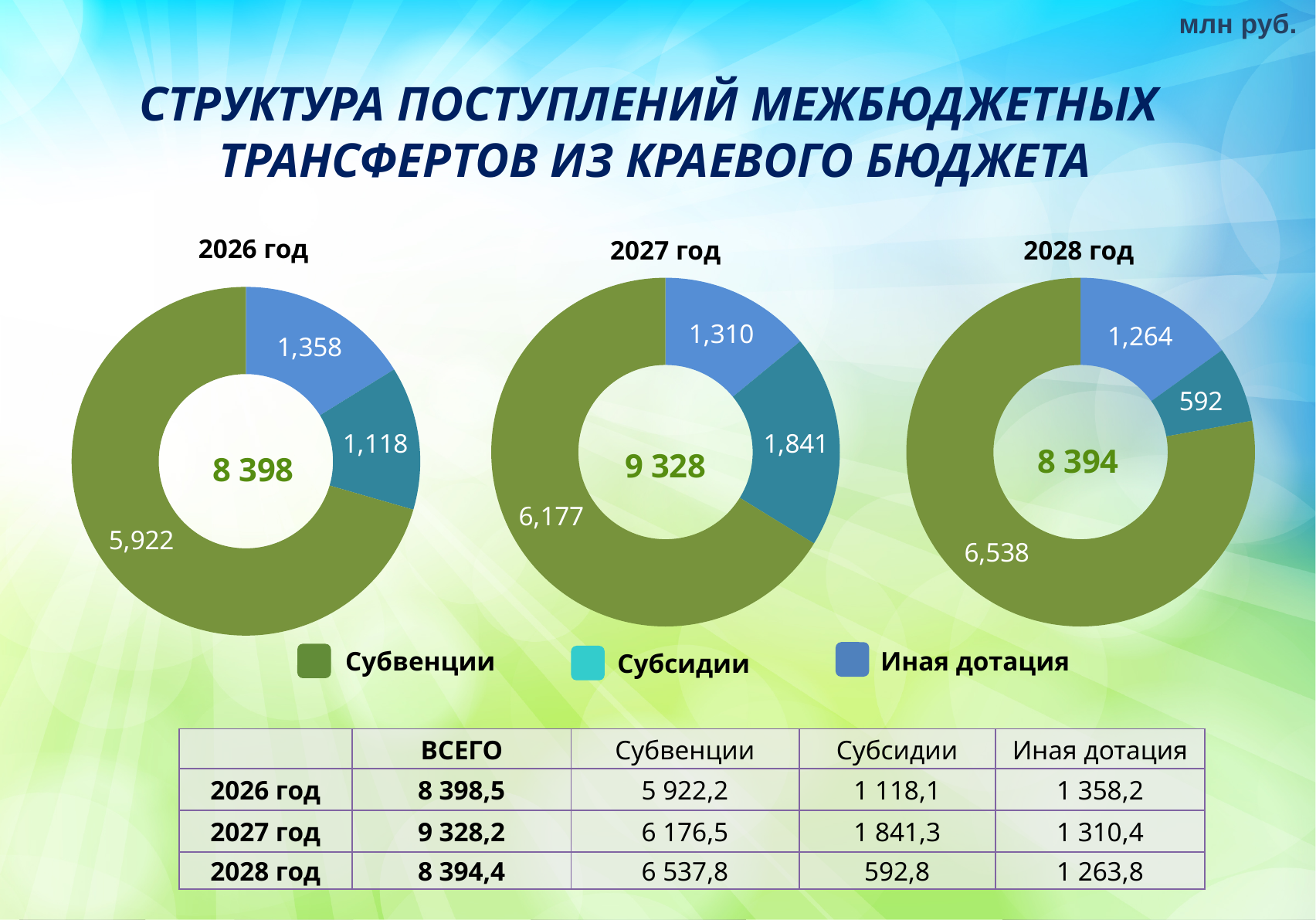
How many entries does the legend list? 3 In the 2026 год chart, what is the value for Субвенции? 5,922 In the 2026 год chart, which category has the largest value? Субвенции In the 2027 год chart, which is larger: Субсидии or Иная дотация? Субсидии In the 2026 год chart, what is the difference between Иная дотация and Субсидии? 240 In the 2028 год chart, what is the value for Иная дотация? 1,264 How many categories does each donut chart show? 3 In the 2027 год chart, what is the value for Субсидии? 1,841 What total is shown in the centre of the 2027 год chart? 9 328 What kind of chart is used for each year on the slide? donut chart In the 2028 год chart, what is the difference between Иная дотация and Субсидии? 672 In the 2028 год chart, which category has the smallest value? Субсидии